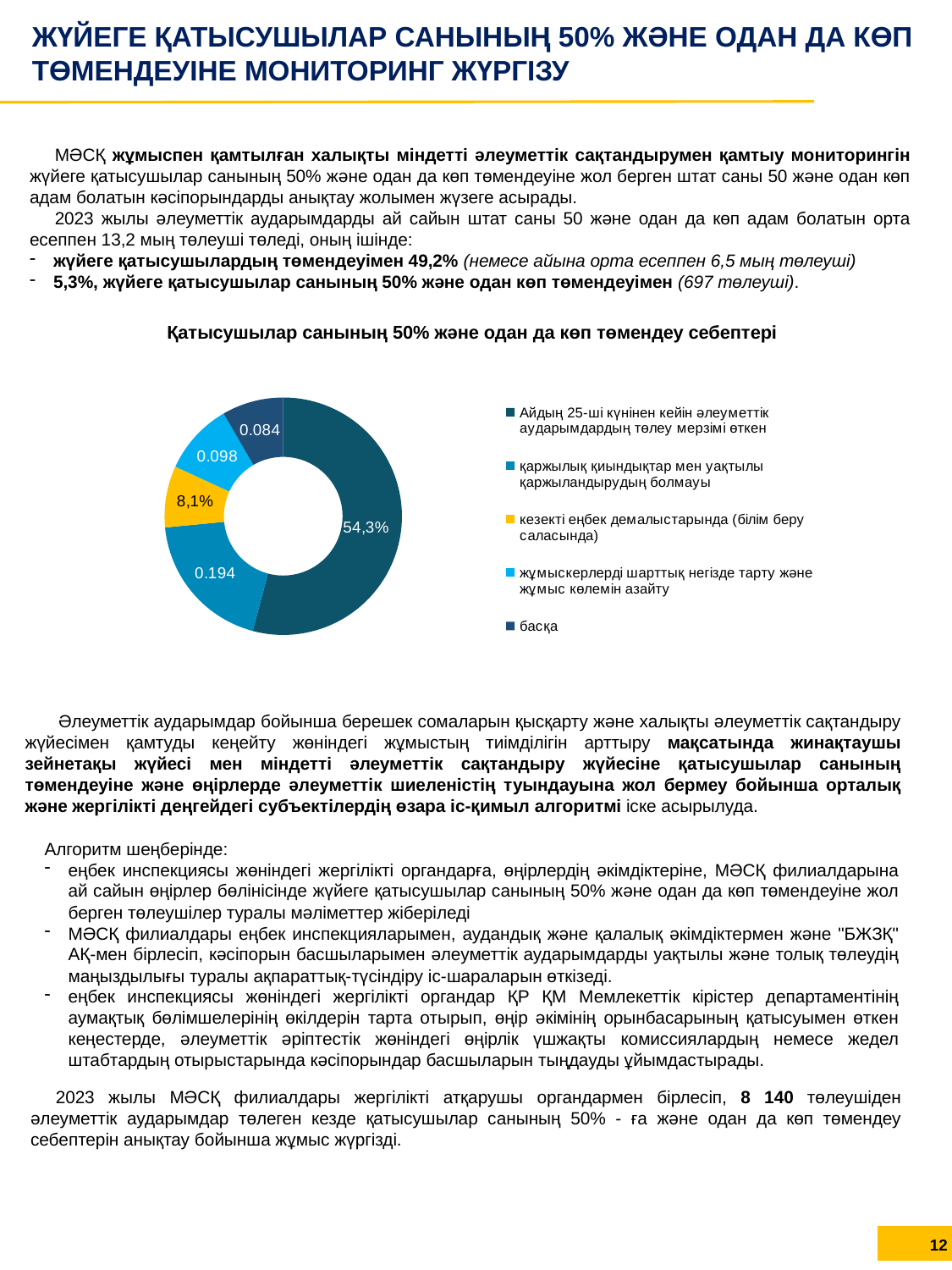
What value is shown for the slice 'жұмыскерлерді шарттық негізде тарту және жұмыс көлемін азайту'? 0.098 How many categories does the chart's legend list? 5 Which category has the largest slice in the chart? Айдың 25-ші күнінен кейін әлеуметтік аударымдардың төлеу мерзімі өткен How many slices does the chart have? 5 Which slice is larger: 'қаржылық қиындықтар мен уақтылы қаржыландырудың болмауы' or 'кезекті еңбек демалыстарында (білім беру саласында)'? қаржылық қиындықтар мен уақтылы қаржыландырудың болмауы What value is shown for the slice 'қаржылық қиындықтар мен уақтылы қаржыландырудың болмауы'? 0.194 What kind of chart is shown on the slide? Pie (doughnut) chart What value is shown for the slice 'Айдың 25-ші күнінен кейін әлеуметтік аударымдардың төлеу мерзімі өткен'? 54,3% What value is shown for the slice 'кезекті еңбек демалыстарында (білім беру саласында)'? 8,1% What value is shown for the slice 'басқа'? 0.084 What is the title of the chart on the slide? Қатысушылар санының 50% және одан да көп төмендеу себептері